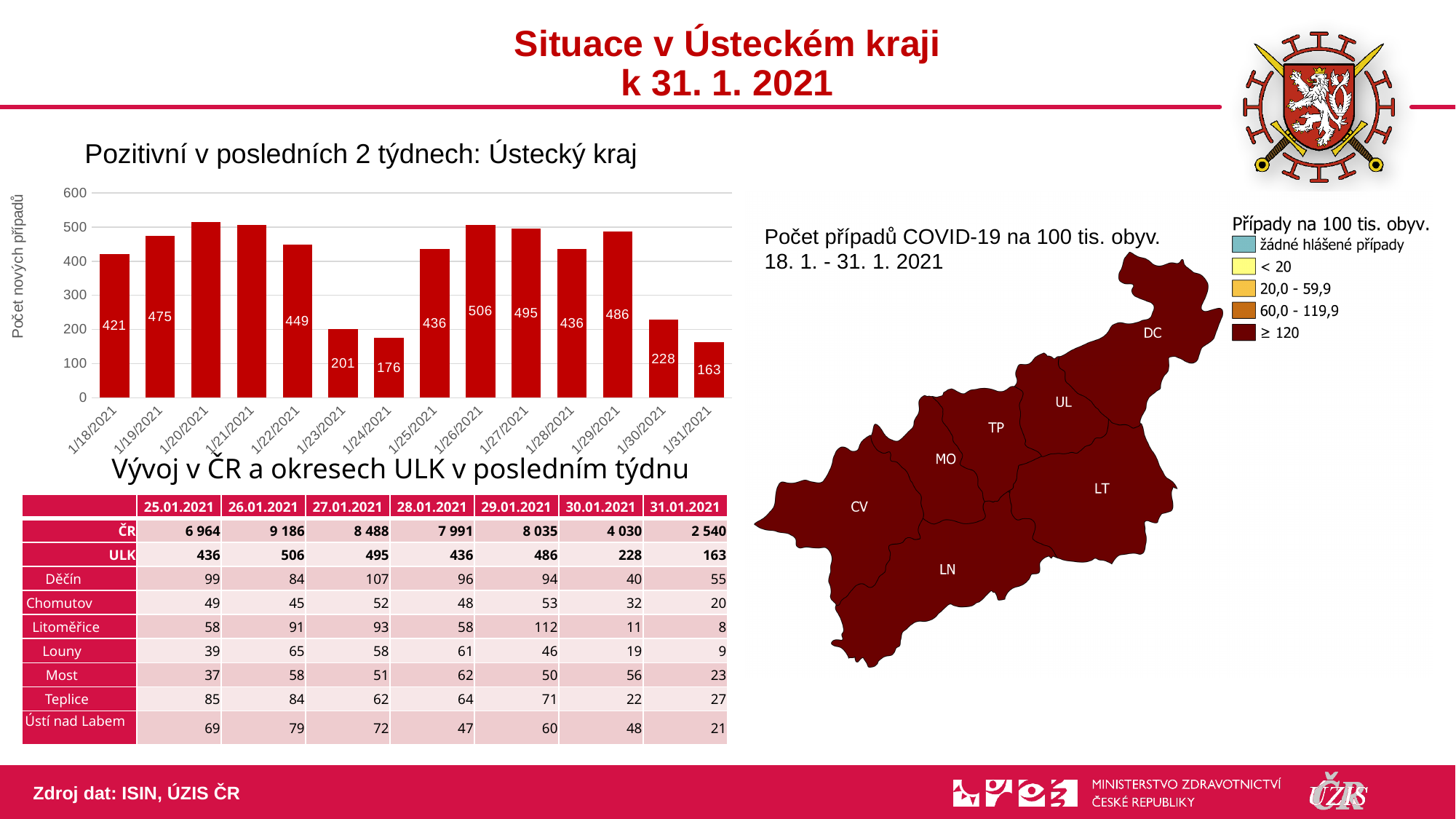
In the bar chart 'Pozitivní v posledních 2 týdnech: Ústecký kraj', what is the value for 1/18/2021? 421 What is the y-axis title of the bar chart 'Pozitivní v posledních 2 týdnech: Ústecký kraj'? Počet nových případů In the bar chart 'Pozitivní v posledních 2 týdnech: Ústecký kraj', is the value for 1/20/2021 greater or less than 400? greater In the bar chart 'Pozitivní v posledních 2 týdnech: Ústecký kraj', what is the value for 1/24/2021? 176 In the bar chart 'Pozitivní v posledních 2 týdnech: Ústecký kraj', which date has the larger value, 1/23/2021 or 1/30/2021? 1/30/2021 In the bar chart 'Pozitivní v posledních 2 týdnech: Ústecký kraj', what is the difference between the values for 1/19/2021 and 1/18/2021? 54 How many bars (dates) are shown in the bar chart 'Pozitivní v posledních 2 týdnech: Ústecký kraj'? 14 In the bar chart 'Pozitivní v posledních 2 týdnech: Ústecký kraj', what is the value for 1/29/2021? 486 What kind of chart is 'Pozitivní v posledních 2 týdnech: Ústecký kraj'? bar chart In the bar chart 'Pozitivní v posledních 2 týdnech: Ústecký kraj', which date has the lowest value? 1/31/2021 In the bar chart 'Pozitivní v posledních 2 týdnech: Ústecký kraj', do the values rise or fall from 1/29/2021 to 1/31/2021? fall In the bar chart 'Pozitivní v posledních 2 týdnech: Ústecký kraj', what is the difference between the values for 1/26/2021 and 1/31/2021? 343